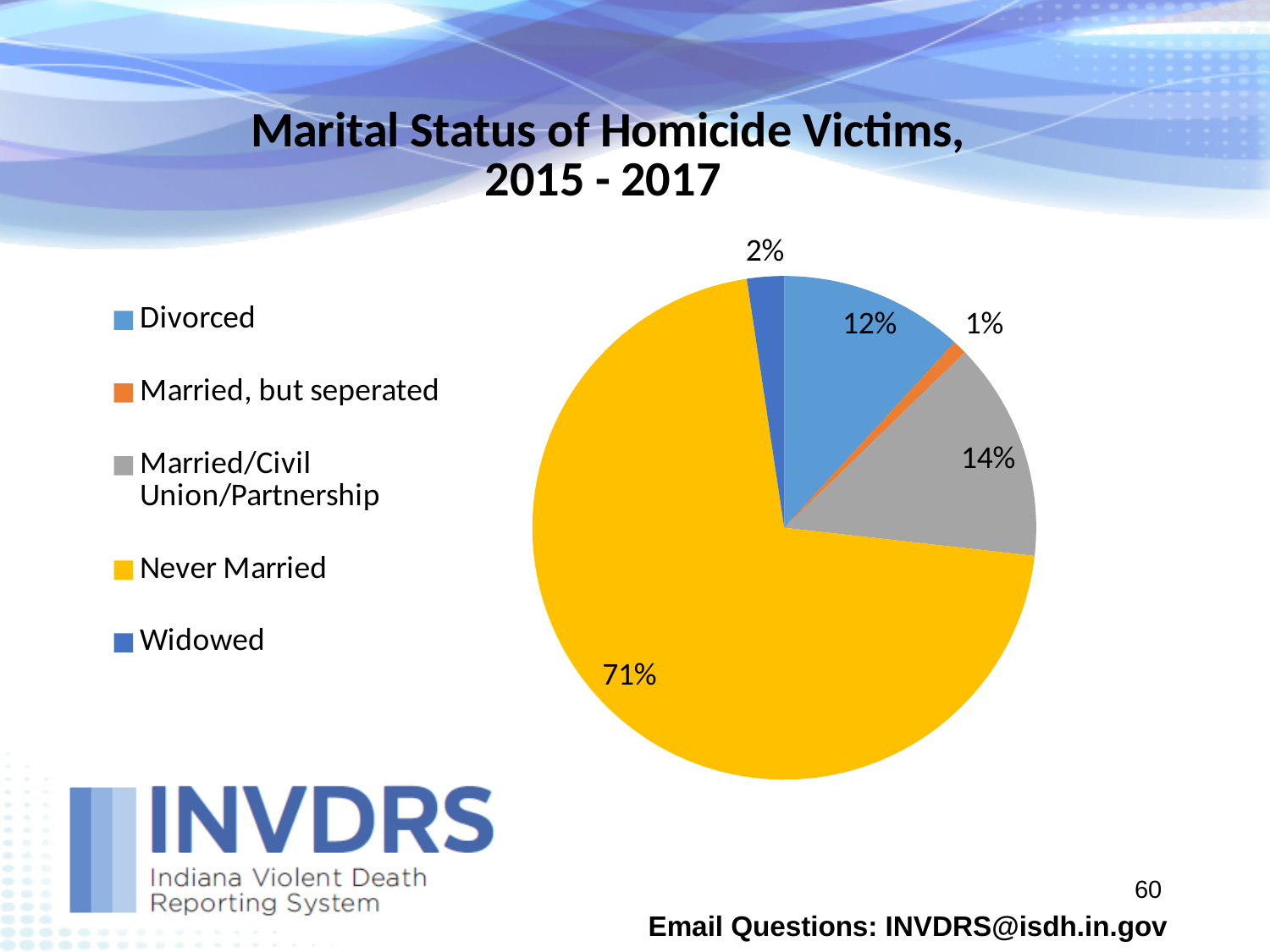
Which marital status category has the smallest share of the pie? Married, but seperated Which marital status category has the largest share of the pie? Never Married What share of homicide victims were Married, but seperated? 1% What share of homicide victims were Married/Civil Union/Partnership? 14% What share of homicide victims were Divorced? 12% What is the title of the chart? Marital Status of Homicide Victims, 2015 - 2017 What kind of chart is shown on the slide? pie chart What is the difference in percentage points between the Never Married and Married/Civil Union/Partnership shares? 57 Which is larger, the share for Divorced or the share for Married/Civil Union/Partnership? Married/Civil Union/Partnership How many marital status categories does the legend list? 5 What share of homicide victims were Widowed? 2% What share of homicide victims were Never Married? 71%